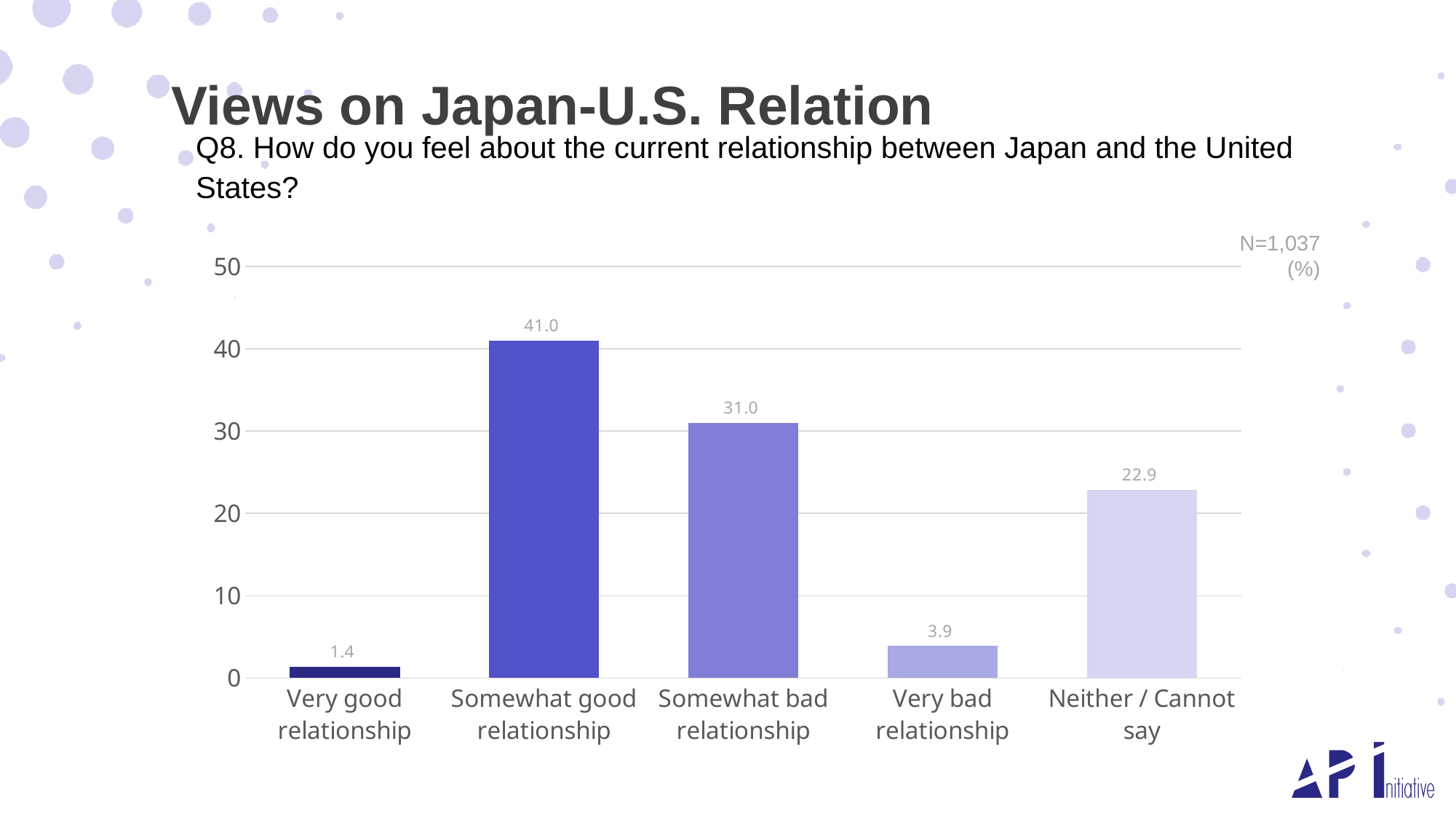
How many categories are shown on the x axis? 5 Is the value for "Neither / Cannot say" greater or less than 20? greater Which category has the highest value? Somewhat good relationship What kind of chart is shown on the slide? bar chart What sample size (N) is shown on the chart? N=1,037 What is the value for "Neither / Cannot say"? 22.9 What is the difference between the values for "Somewhat good relationship" and "Somewhat bad relationship"? 10.0 What is the value for "Somewhat good relationship"? 41.0 What is the value for "Very bad relationship"? 3.9 What is the value for "Very good relationship"? 1.4 Which category has the lowest value? Very good relationship Which is larger, the value for "Somewhat bad relationship" or the value for "Neither / Cannot say"? Somewhat bad relationship